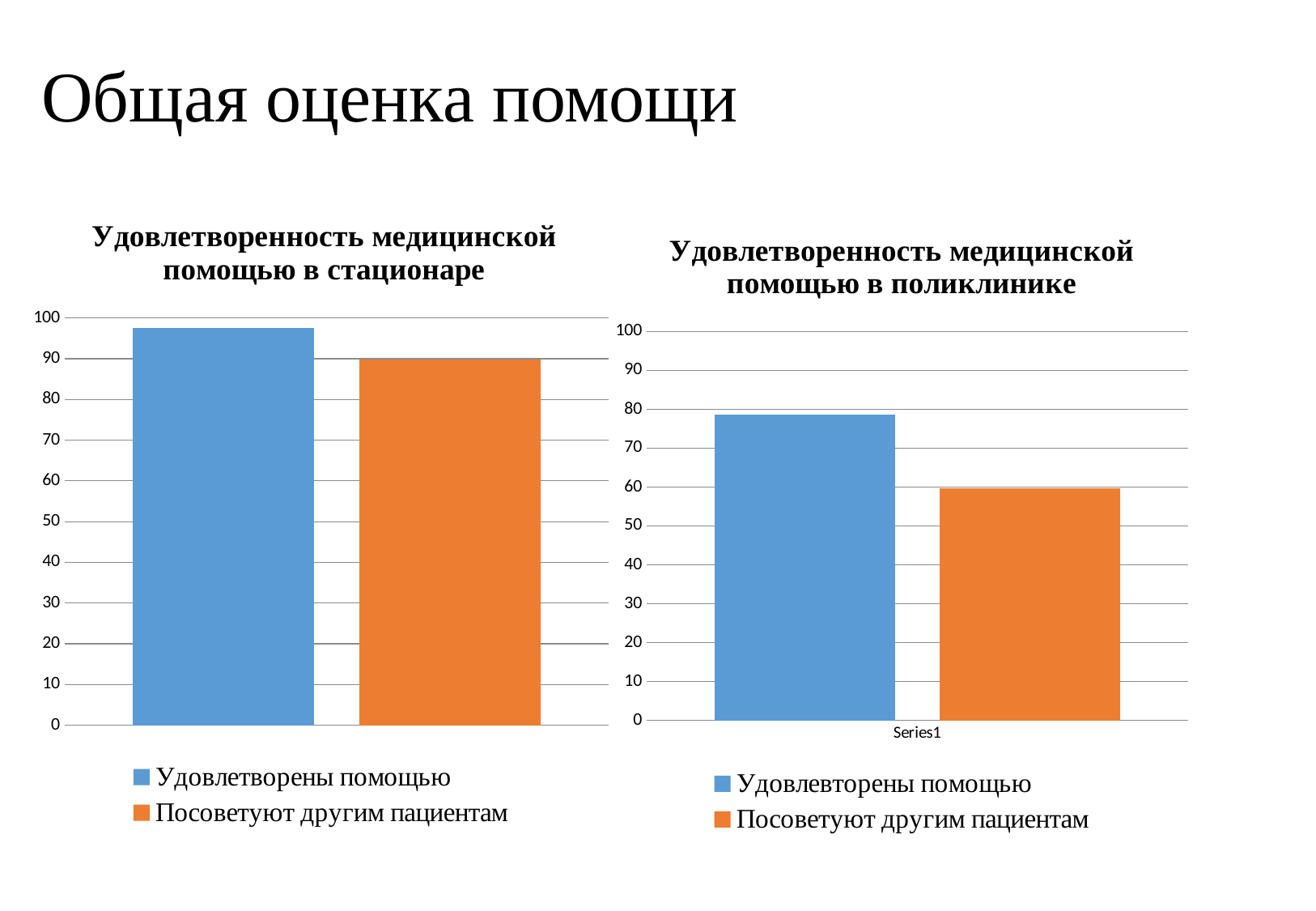
How many series does the legend list in the chart titled "Удовлетворенность медицинской помощью в поликлинике"? 2 What kind of chart is the chart titled "Удовлетворенность медицинской помощью в стационаре"? bar chart Which is larger: the "Посоветуют другим пациентам" bar in the left chart (стационаре) or the "Посоветуют другим пациентам" bar in the right chart (поликлинике)? the left chart (стационаре) In the chart titled "Удовлетворенность медицинской помощью в поликлинике", which series has the lower bar? Посоветуют другим пациентам In the chart titled "Удовлетворенность медицинской помощью в поликлинике", is the value for "Удовлевторены помощью" greater or less than 70? greater In the chart titled "Удовлетворенность медицинской помощью в стационаре", is the value for "Удовлетворены помощью" greater or less than 90? greater In the chart titled "Удовлетворенность медицинской помощью в поликлинике", is the value for "Посоветуют другим пациентам" greater or less than 70? less In the chart titled "Удовлетворенность медицинской помощью в стационаре", what colour is the bar for "Посоветуют другим пациентам"? orange In the chart titled "Удовлетворенность медицинской помощью в стационаре", which series has the higher bar? Удовлетворены помощью What is the title of the chart on the right side of the slide? Удовлетворенность медицинской помощью в поликлинике